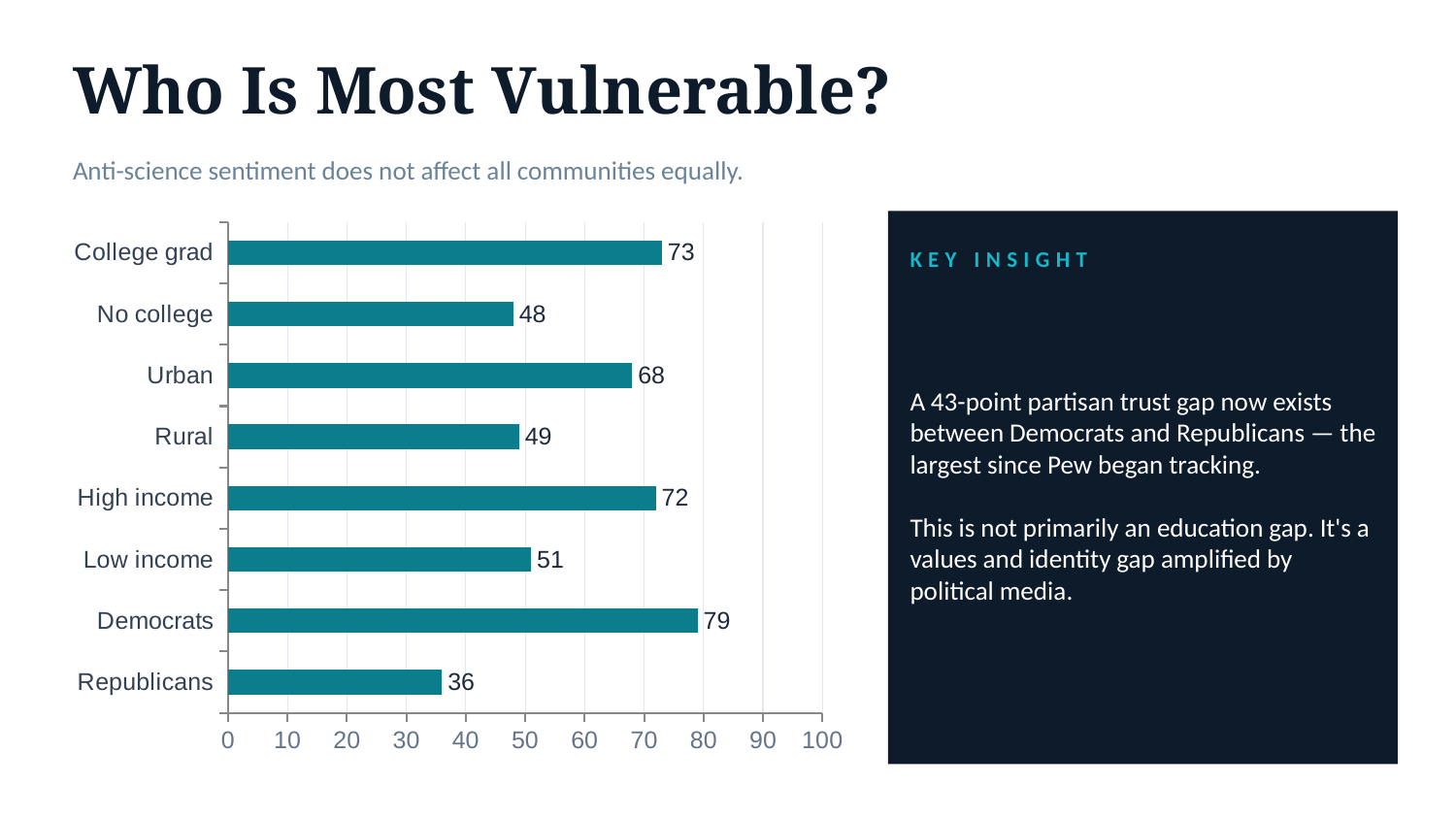
What is the difference between the values for Democrats and Republicans? 43 What kind of chart is shown on the slide? Bar chart What is the value for No college? 48 How many categories are shown in the chart? 8 Which is larger, the value for High income or the value for Low income? High income Which category has the lowest value? Republicans Which category has the highest value? Democrats What is the value for Urban? 68 What is the maximum value shown on the x axis? 100 What is the value for Republicans? 36 What is the value for Democrats? 79 What is the difference between the values for College grad and No college? 25